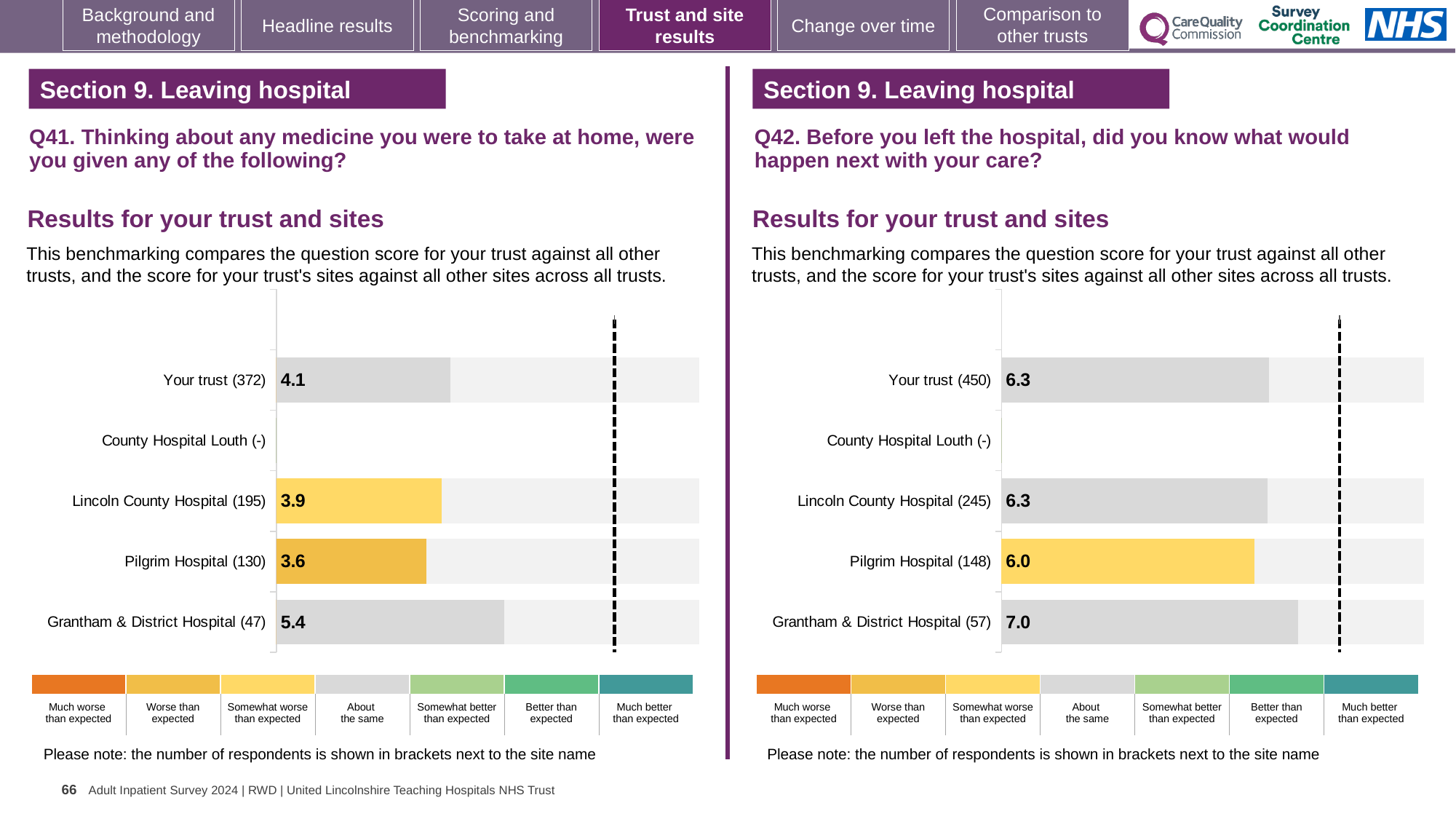
In the Q42 chart on the right, what is the difference between the scores for Grantham & District Hospital (57) and Pilgrim Hospital (148)? 1.0 In the Q41 chart on the left, which site has the lowest score? Pilgrim Hospital (130) How many site/trust labels are listed on the y axis of the Q41 chart on the left? 5 In the Q42 chart on the right, which is larger: the score for Grantham & District Hospital (57) or Your trust (450)? Grantham & District Hospital (57) In the Q42 chart on the right, what is the score for Pilgrim Hospital (148)? 6.0 What kind of chart is used for the Q42 results on the right? Bar chart In the Q41 chart on the left, what is the score for Your trust (372)? 4.1 In the Q42 chart on the right, which site has the lowest score? Pilgrim Hospital (148) In the Q42 chart on the right, what is the score for Grantham & District Hospital (57)? 7.0 In the Q41 chart on the left, what is the score for Pilgrim Hospital (130)? 3.6 In the Q41 chart on the left, what is the difference between the scores for Grantham & District Hospital (47) and Lincoln County Hospital (195)? 1.5 In the Q41 chart on the left, which site has the highest score? Grantham & District Hospital (47)